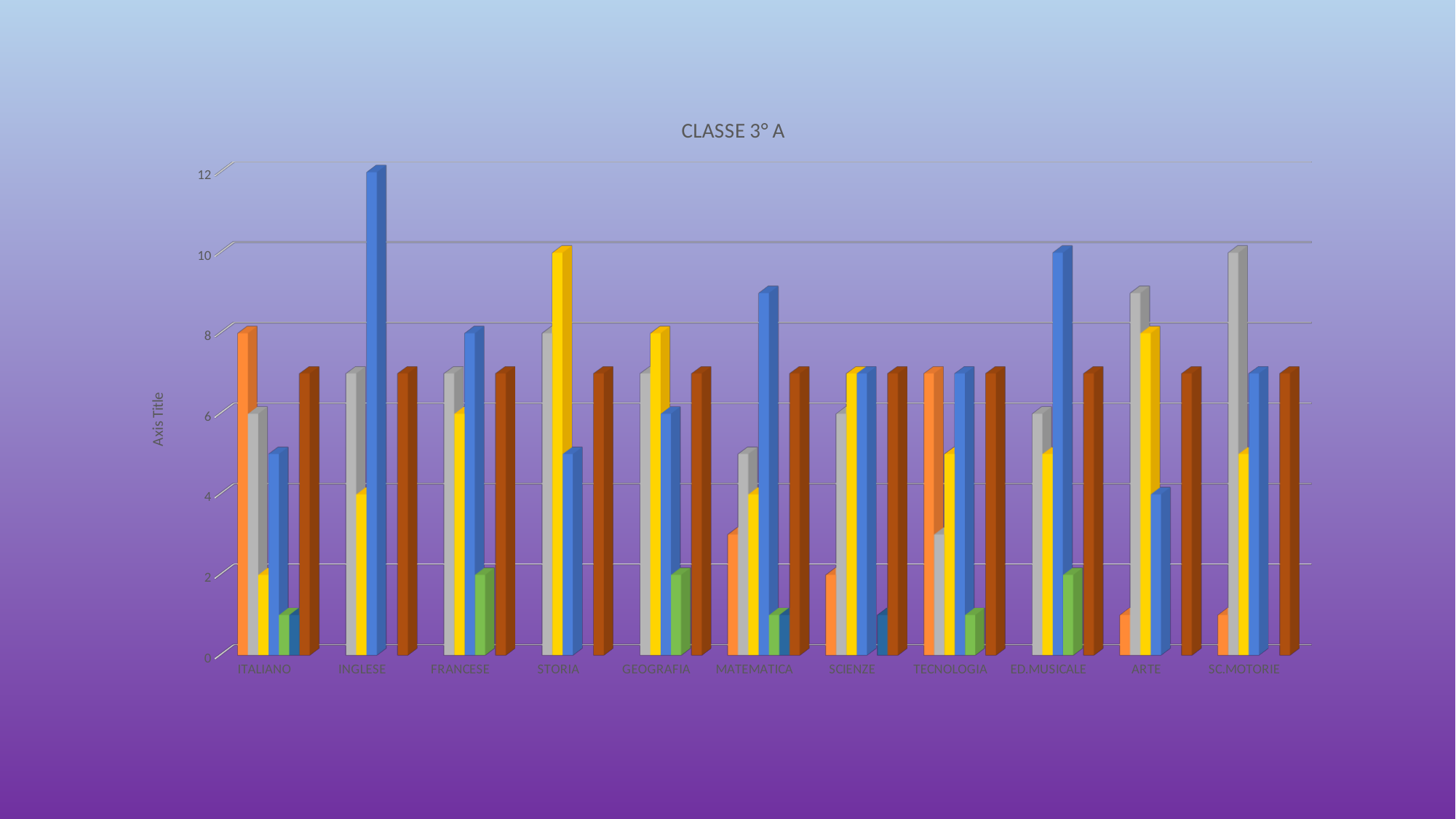
Which is larger: the blue bar for INGLESE or the blue bar for ITALIANO? INGLESE Is the value of the yellow bar for STORIA greater or less than 8? greater What label is shown on the vertical axis of the chart? Axis Title Is the value of the green bar for MATEMATICA greater or less than 2? less Is the value of the blue bar for INGLESE greater or less than 10? greater What kind of chart is shown on the slide? bar chart What value does the blue bar for INGLESE reach? 12 How many categories are shown along the x axis of the chart? 11 What is the title of the chart? CLASSE 3° A Which category contains the tallest bar in the chart? INGLESE